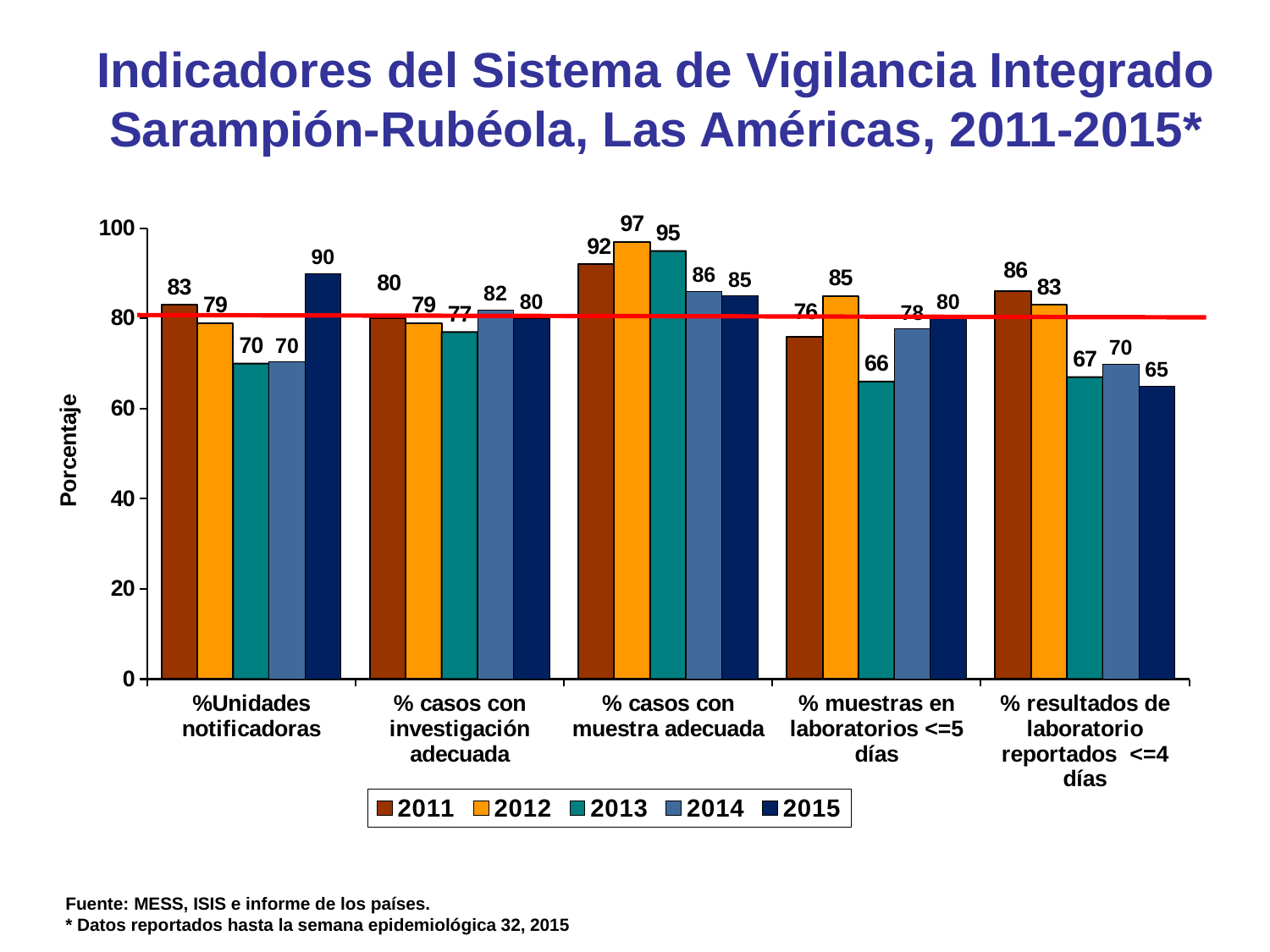
At what value on the y axis is the horizontal red line drawn? 80 What is the value for 2013 in the "% muestras en laboratorios <=5 días" category? 66 How many indicator categories are shown on the x axis? 5 What kind of chart is shown on the slide? Bar chart Which year has the lowest value in the "% casos con muestra adecuada" category? 2015 Which year has the highest value in the "% resultados de laboratorio reportados <=4 días" category? 2011 What is the value for 2012 in the "% casos con muestra adecuada" category? 97 What is the label of the y axis? Porcentaje What is the difference between the 2011 and 2015 values in the "% resultados de laboratorio reportados <=4 días" category? 21 How many series does the legend list? 5 In the "% muestras en laboratorios <=5 días" category, which is larger: the 2012 value or the 2014 value? 2012 What is the value for 2015 in the "%Unidades notificadoras" category? 90